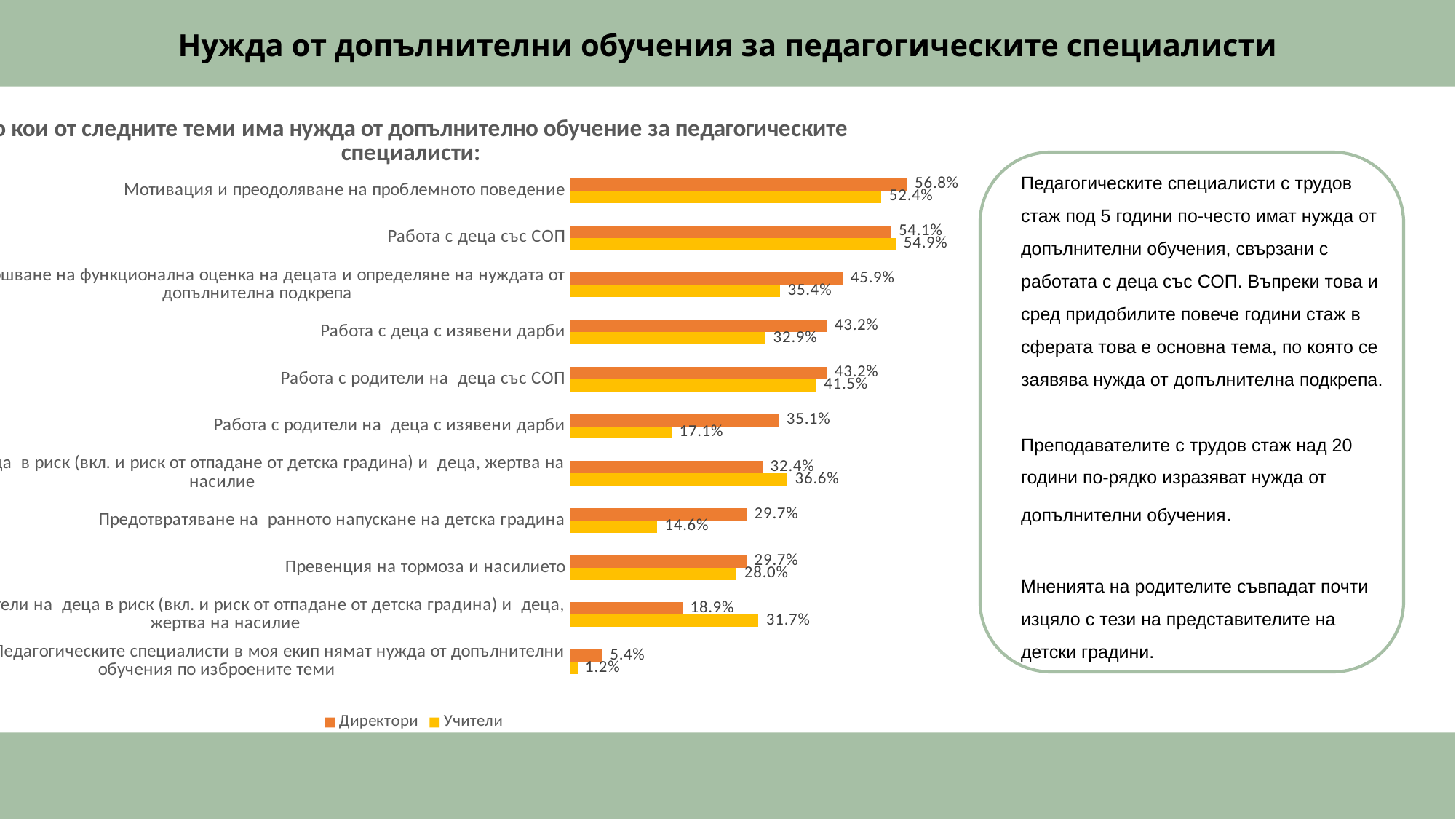
What kind of chart is shown on the slide? bar chart For "Превенция на тормоза и насилието", which series has the larger value, Директори or Учители? Директори What is the value for Учители for "Работа с родители на деца с изявени дарби"? 17.1% Which series is shown in orange in the chart legend? Директори What is the value for Директори for "Мотивация и преодоляване на проблемното поведение"? 56.8% How many series does the chart legend list? 2 What is the value for Директори for "Предотвратяване на ранното напускане на детска градина"? 29.7% What is the value for Учители for "Работа с деца със СОП"? 54.9% Which category has the lowest value for Учители? Педагогическите специалисти в моя екип нямат нужда от допълнителни обучения по изброените теми How many categories are plotted in the chart? 11 What is the difference between the Директори and Учители values for "Работа с деца с изявени дарби"? 10.3% Which category has the highest value for Директори? Мотивация и преодоляване на проблемното поведение